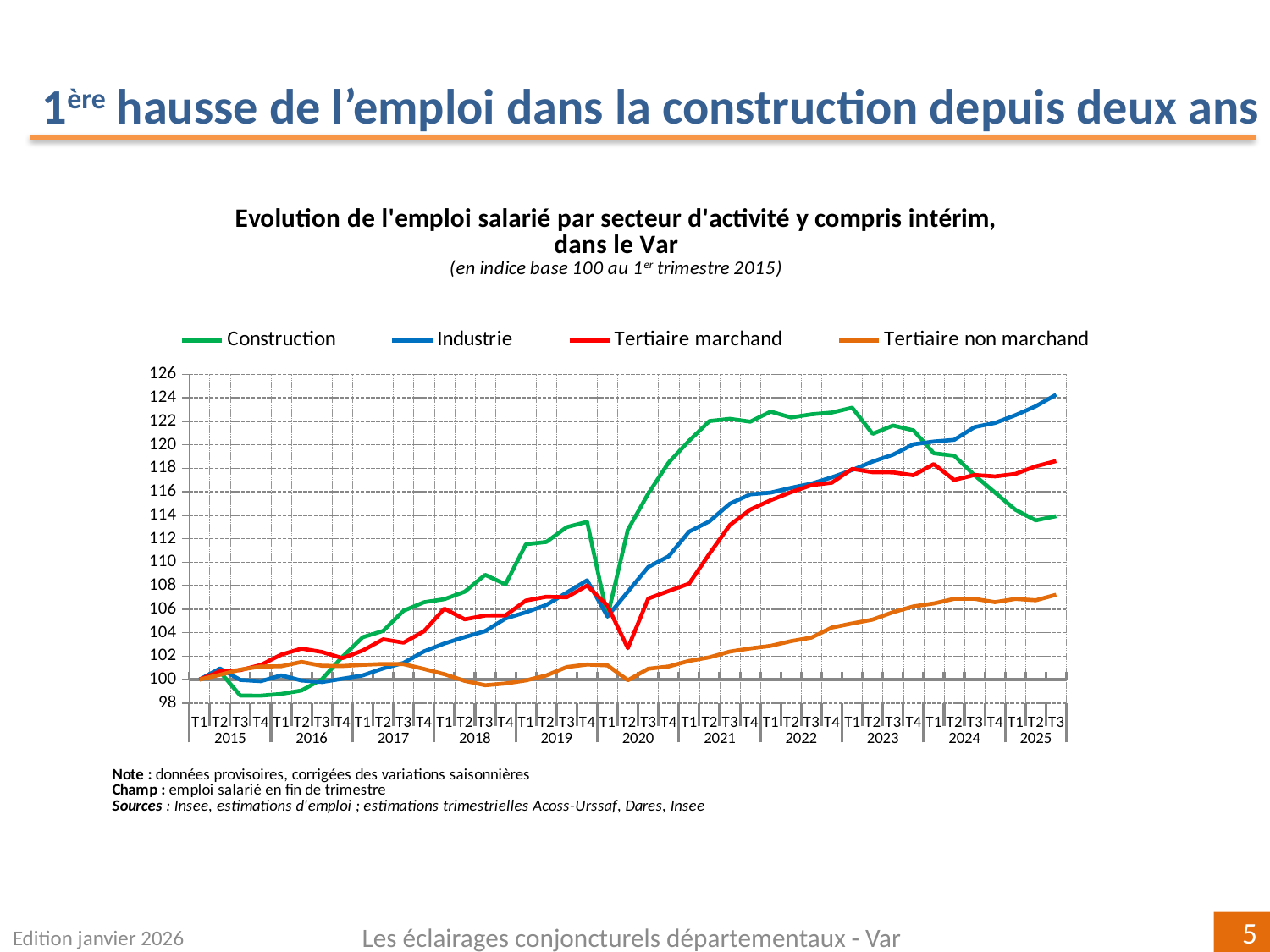
Is the value for Tertiaire non marchand at T3 2025 greater or less than 110? less Which series has the lowest value at T3 2025? Tertiaire non marchand At T3 2025, which is larger: Industrie or Construction? Industrie How many series does the legend list? 4 At T1 2020, which is larger: Construction or Tertiaire non marchand? Construction What colour is the Construction line in the legend? green Does the Industrie series rise or fall between T1 2021 and T3 2025? rise What kind of chart is shown on the slide? line chart Which series has the highest value at T3 2025? Industrie Is the value for Construction at T3 2025 greater or less than 116? less Is the value for Industrie at T3 2025 greater or less than 122? greater How many years are labelled on the x axis? 11